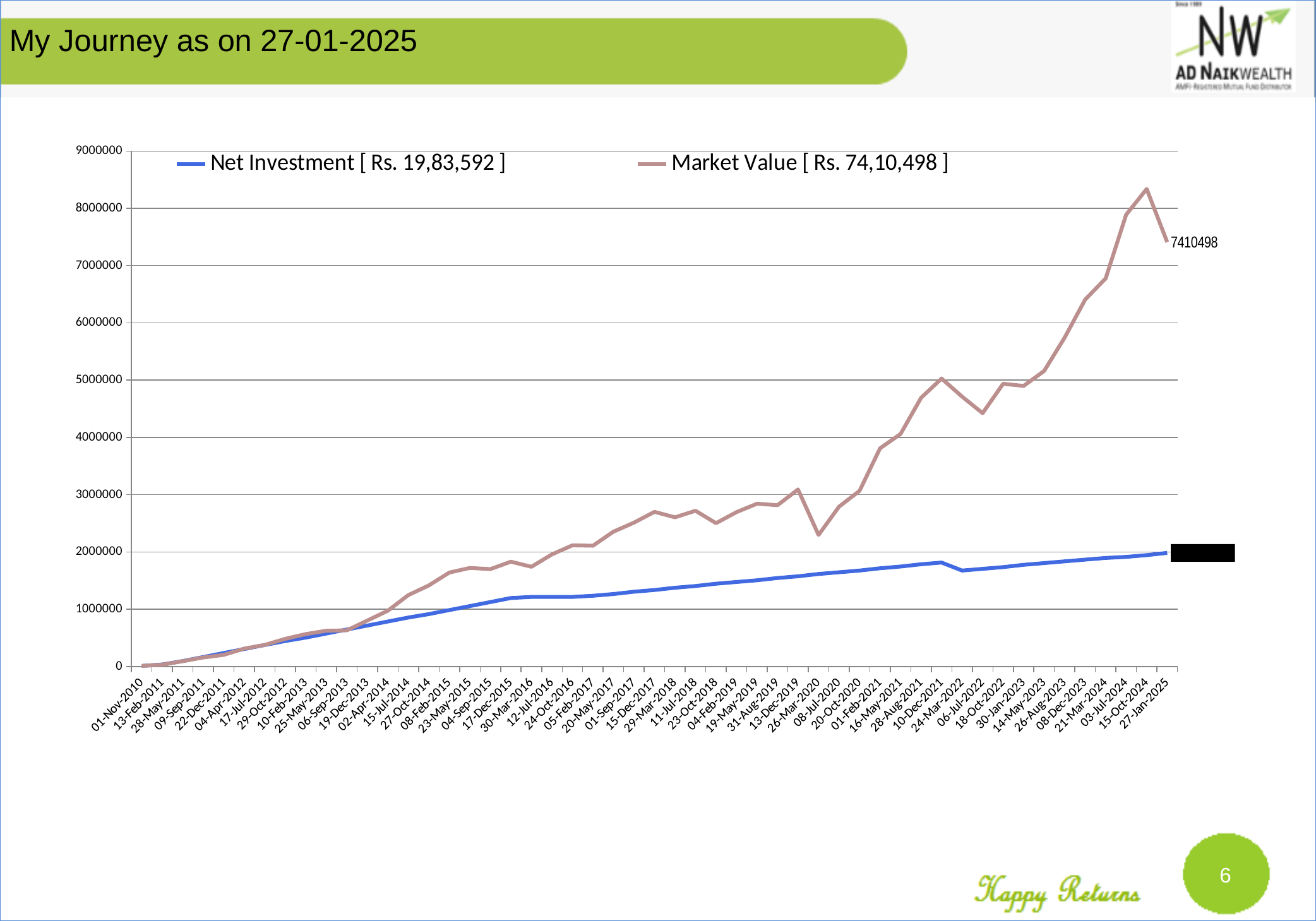
Which series reaches the highest value on the chart? Market Value Is the Market Value on 15-Oct-2024 greater or less than 8000000? greater What is the title of the slide containing the chart? My Journey as on 27-01-2025 How many series does the chart's legend list? 2 What is the Market Value on 27-Jan-2025 according to the data label? 7410498 What is the full legend entry for the Net Investment series? Net Investment [ Rs. 19,83,592 ] Is the Net Investment on 01-Feb-2021 greater or less than 2000000? less On 27-Jan-2025, which is larger: Market Value or Net Investment? Market Value Is the Market Value on 10-Dec-2021 greater or less than 4000000? greater Does the Net Investment line generally rise or fall from 01-Nov-2010 to 27-Jan-2025? rise What kind of chart is shown on the slide? line chart